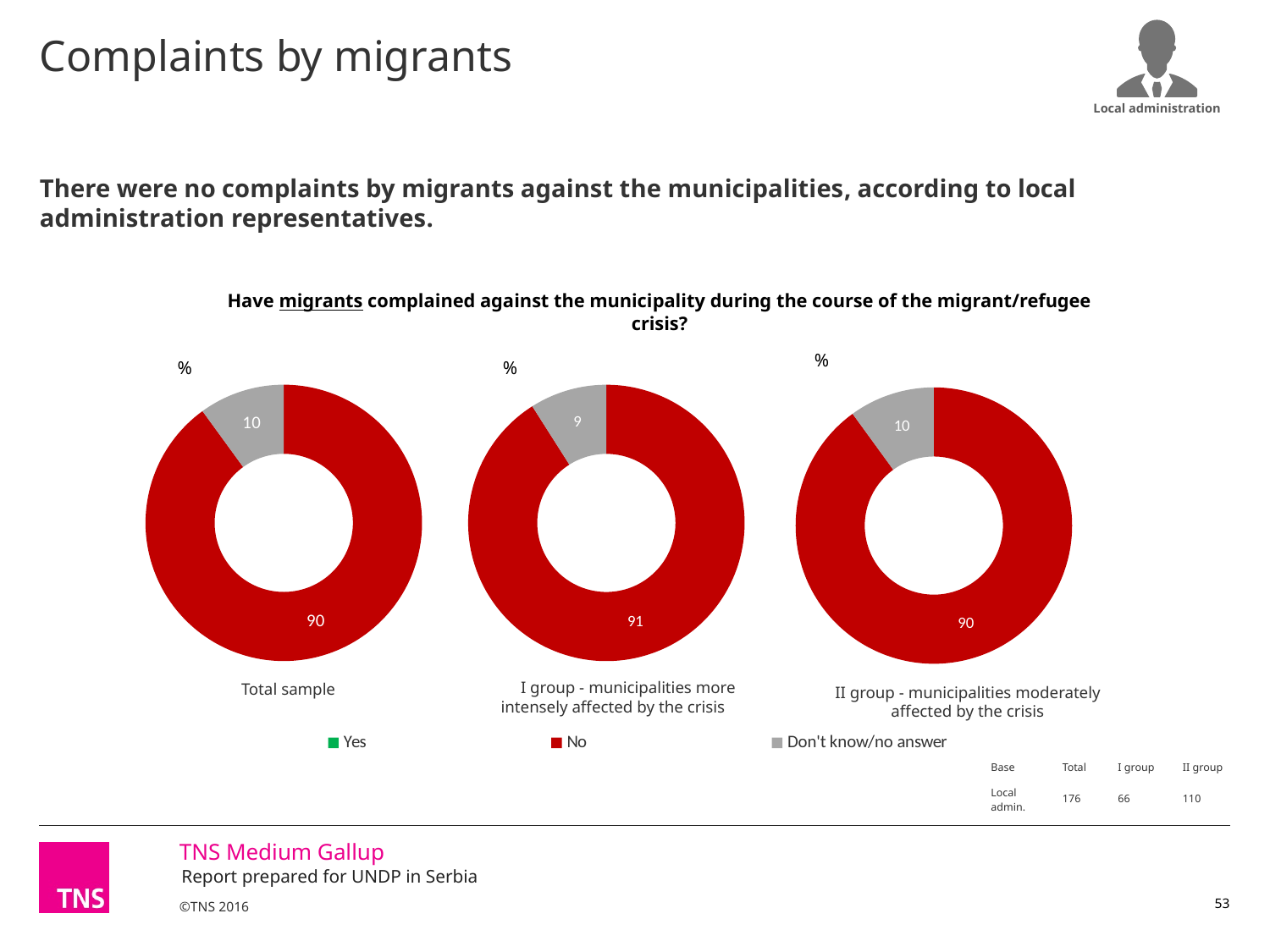
In the I group chart (municipalities more intensely affected by the crisis), what percentage answered No? 91 What colour represents the No response in the charts? Red How many donut charts are shown on the slide? 3 In the II group chart (municipalities moderately affected by the crisis), what percentage answered Don't know/no answer? 10 In the I group chart, what percentage answered Don't know/no answer? 9 In the Total sample chart, what is the combined share of No and Don't know/no answer? 100 Which chart shows a higher No share, the I group chart or the II group chart? I group In the Total sample chart, which response has the largest share? No What type of chart is used on this slide? Donut (pie) chart In the I group chart, what is the difference between the No share and the Don't know/no answer share? 82 In the Total sample chart, what percentage answered No? 90 How many response categories does the legend list? 3